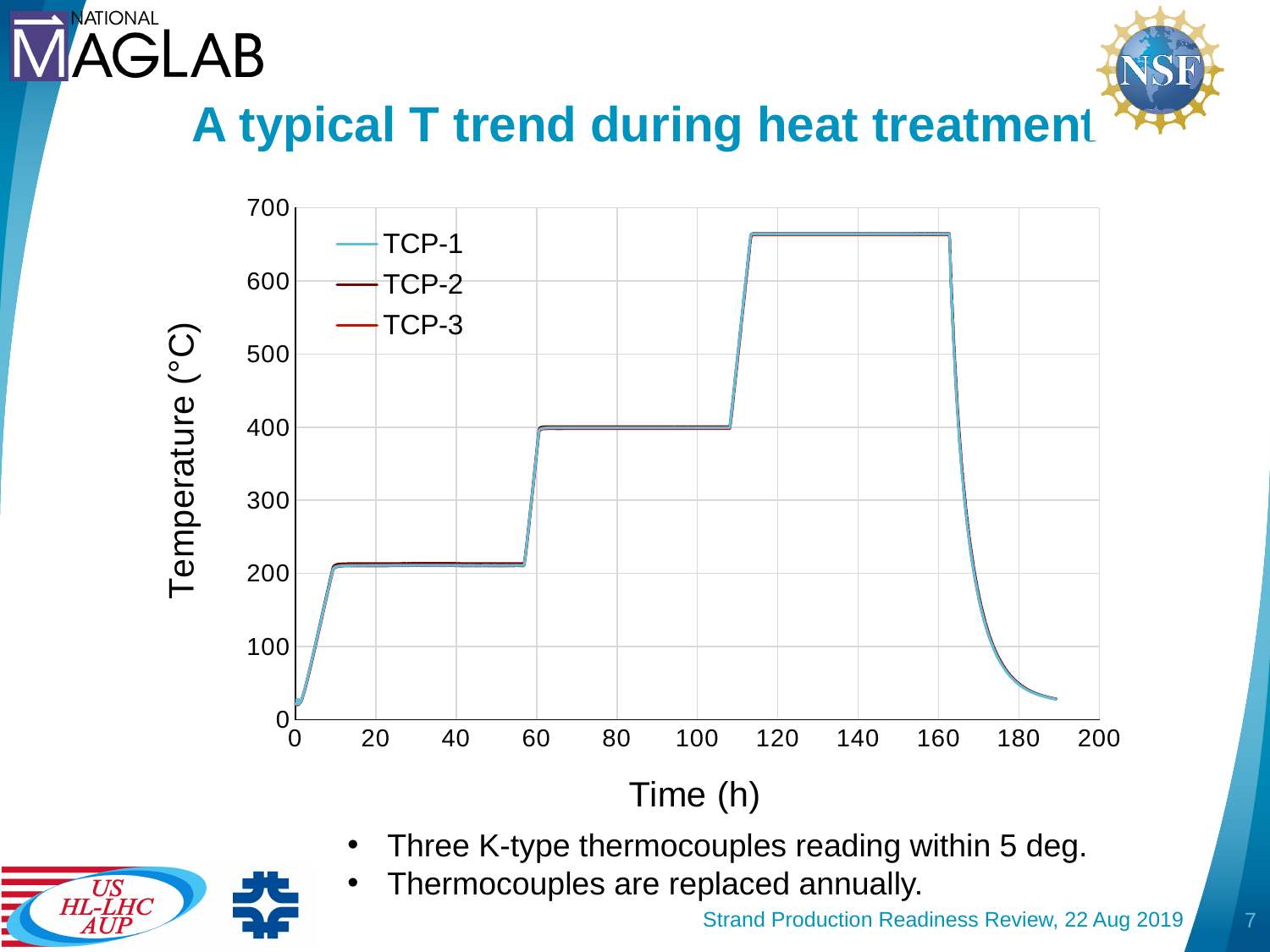
What kind of chart is shown on the slide? line chart Is the temperature at 80 h greater or less than 300? greater Is the temperature at 140 h greater or less than 600? greater Is the temperature at 180 h greater or less than 200? less What is the label of the y axis? Temperature (°C) Which is larger, the temperature at 80 h or the temperature at 140 h? 140 h Does the temperature rise or fall between 0 h and 120 h? rise How many series does the legend list? 3 Does the temperature rise or fall between 165 h and 190 h? fall What are the names of the series in the legend? TCP-1, TCP-2, TCP-3